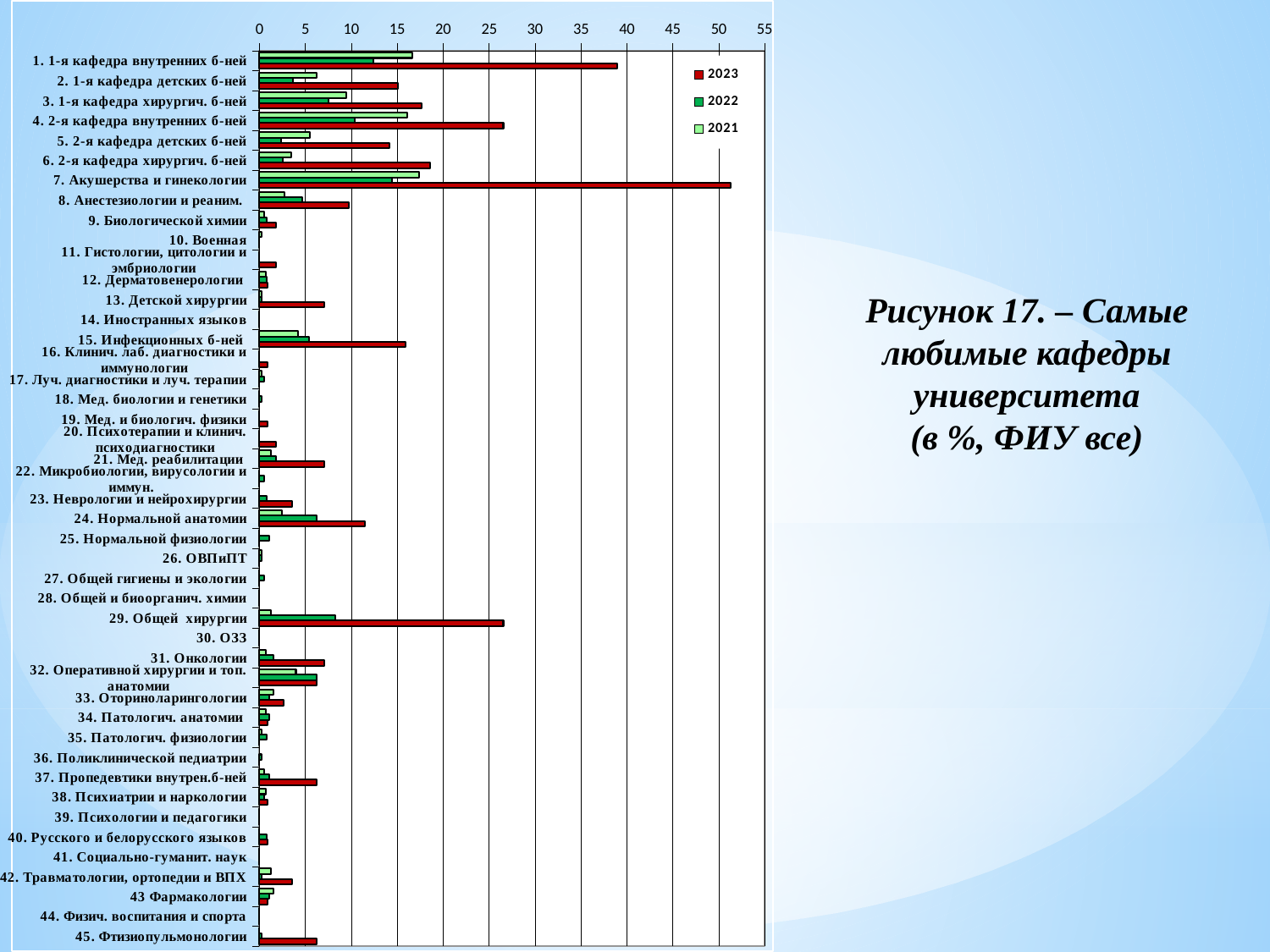
Is the 2023 value for 1. 1-я кафедра внутренних б-ней greater or less than 35? greater Is the 2023 value for 7. Акушерства и гинекологии greater or less than 45? greater Is the 2023 value for 24. Нормальной анатомии greater or less than 10? greater What kind of chart is shown on the slide? Bar chart How many series does the legend list? 3 Which colour represents the 2023 series in the chart? Red Which has the larger 2023 value: 1. 1-я кафедра внутренних б-ней or 4. 2-я кафедра внутренних б-ней? 1. 1-я кафедра внутренних б-ней Which years are listed in the legend? 2023, 2022, 2021 How many departments (categories) are shown on the chart? 45 Which department has the highest value for 2023? 7. Акушерства и гинекологии